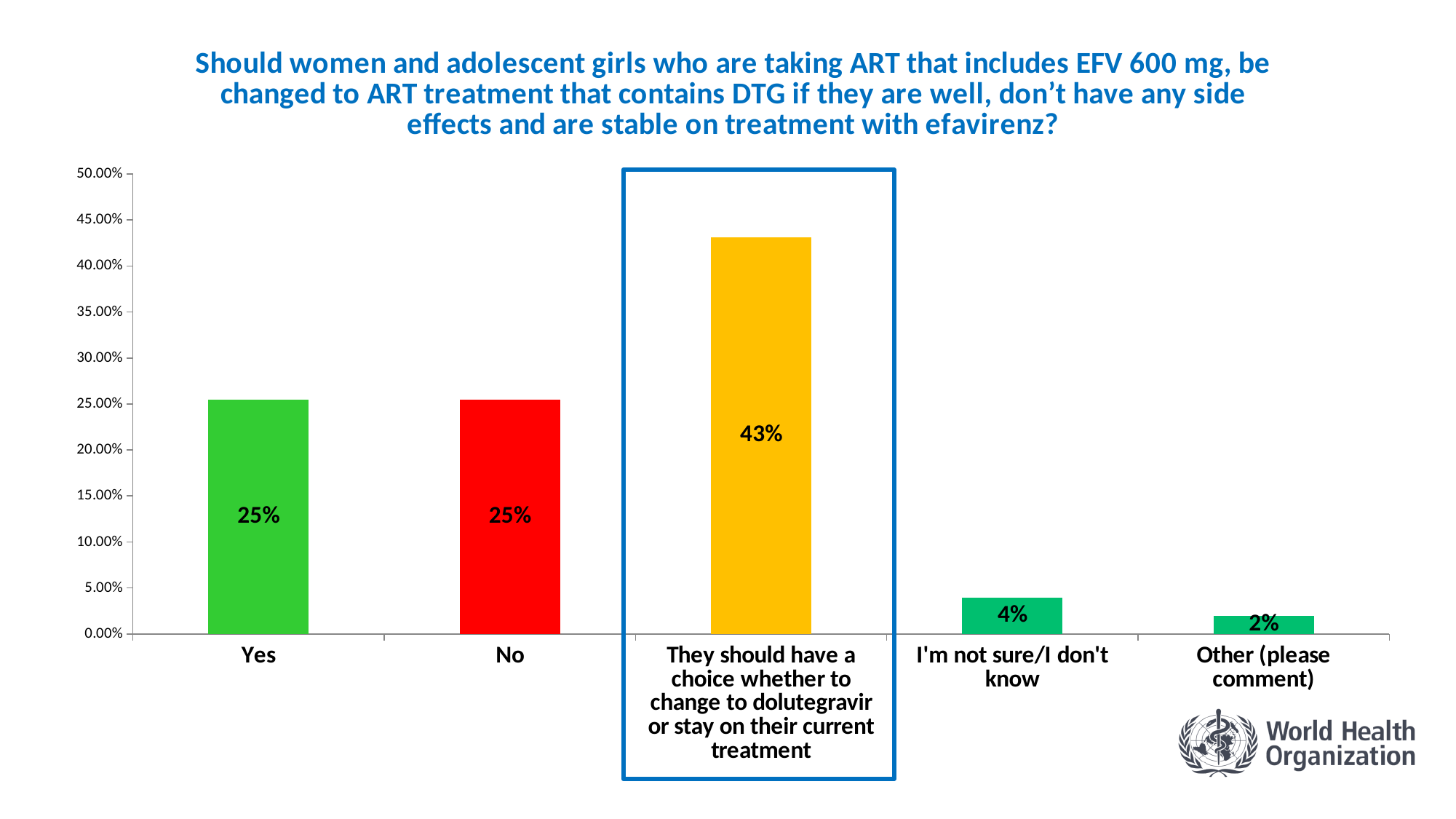
What percentage of respondents chose "They should have a choice whether to change to dolutegravir or stay on their current treatment"? 43% What is the difference in percentage points between "They should have a choice" and "Yes"? 18 What percentage of respondents answered "Yes"? 25% How many response categories are shown on the chart? 5 Which is larger, the percentage for "I'm not sure/I don't know" or for "Other (please comment)"? I'm not sure/I don't know Which response option received the highest percentage? They should have a choice whether to change to dolutegravir or stay on their current treatment What type of chart is shown on the slide? Bar chart Which response option received the lowest percentage? Other (please comment) Which bar is highlighted with a blue outlined box? They should have a choice whether to change to dolutegravir or stay on their current treatment What percentage of respondents answered "Other (please comment)"? 2% What percentage of respondents answered "No"? 25% What percentage of respondents answered "I'm not sure/I don't know"? 4%